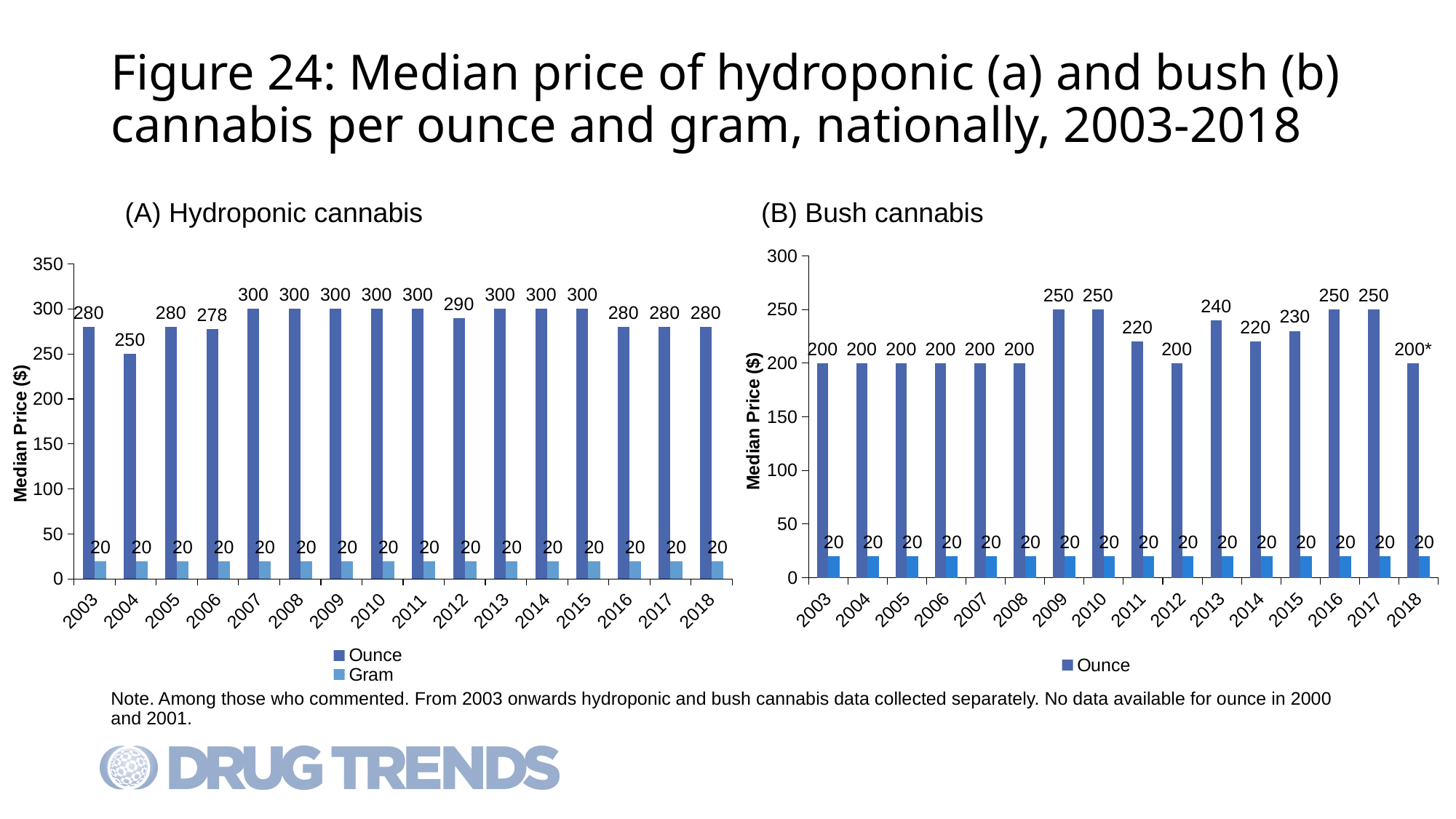
In the (B) Bush cannabis chart, what is the median price per ounce in 2015? 230 What kind of chart is the (B) Bush cannabis chart? Bar chart In the (A) Hydroponic cannabis chart, what is the median price per ounce in 2004? 250 In the (B) Bush cannabis chart, what is the difference between the ounce price in 2016 and the ounce price in 2012? 50 In the (B) Bush cannabis chart, what is the median price per ounce in 2013? 240 In the (A) Hydroponic cannabis chart, what is the difference between the ounce price in 2007 and the ounce price in 2004? 50 In the (A) Hydroponic cannabis chart, how many series does the legend list? 2 In the (A) Hydroponic cannabis chart, how many years are shown on the x axis? 16 In the (A) Hydroponic cannabis chart, which year has the lowest median price per ounce? 2004 In the (A) Hydroponic cannabis chart, what is the median price per ounce in 2006? 278 In the (B) Bush cannabis chart, what is the label on the y axis? Median Price ($) In the (B) Bush cannabis chart, which is larger: the ounce price in 2009 or the ounce price in 2011? 2009